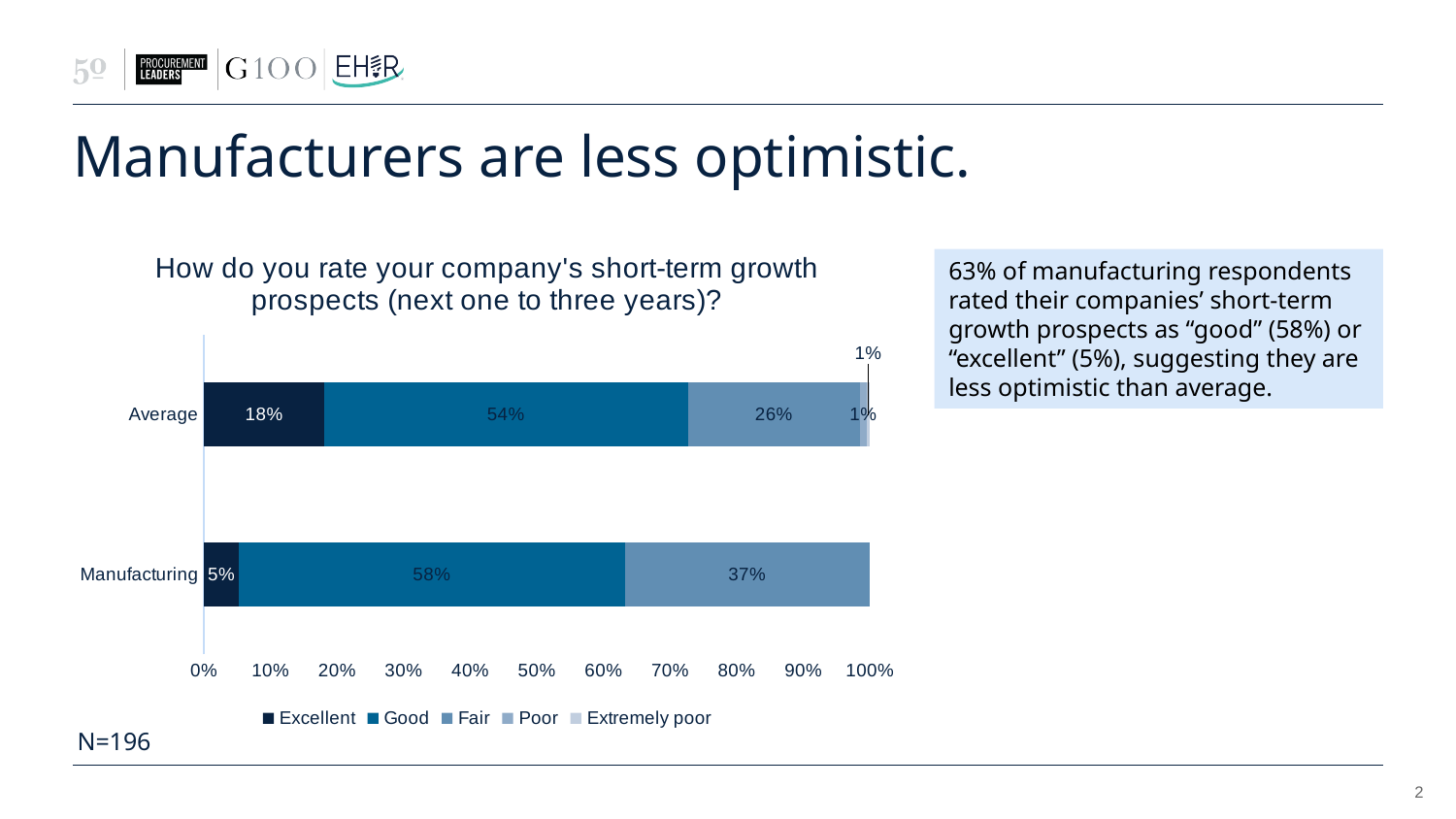
What percentage of Average respondents rated their short-term growth prospects as Fair? 26% What kind of chart is shown on the slide? Stacked bar chart Which category has the larger Good share, Average or Manufacturing? Manufacturing How many series does the chart legend list? 5 What percentage of Average respondents rated their short-term growth prospects as Good? 54% Which category has the larger Excellent share, Average or Manufacturing? Average How many categories are shown on the y axis of the chart? 2 What percentage of Manufacturing respondents rated their short-term growth prospects as Excellent? 5% What is the title of the chart? How do you rate your company's short-term growth prospects (next one to three years)? What percentage of Manufacturing respondents rated their short-term growth prospects as Fair? 37% What is the difference between the Fair share for Manufacturing and for Average? 11% What is the difference between the Excellent share for Average and for Manufacturing? 13%